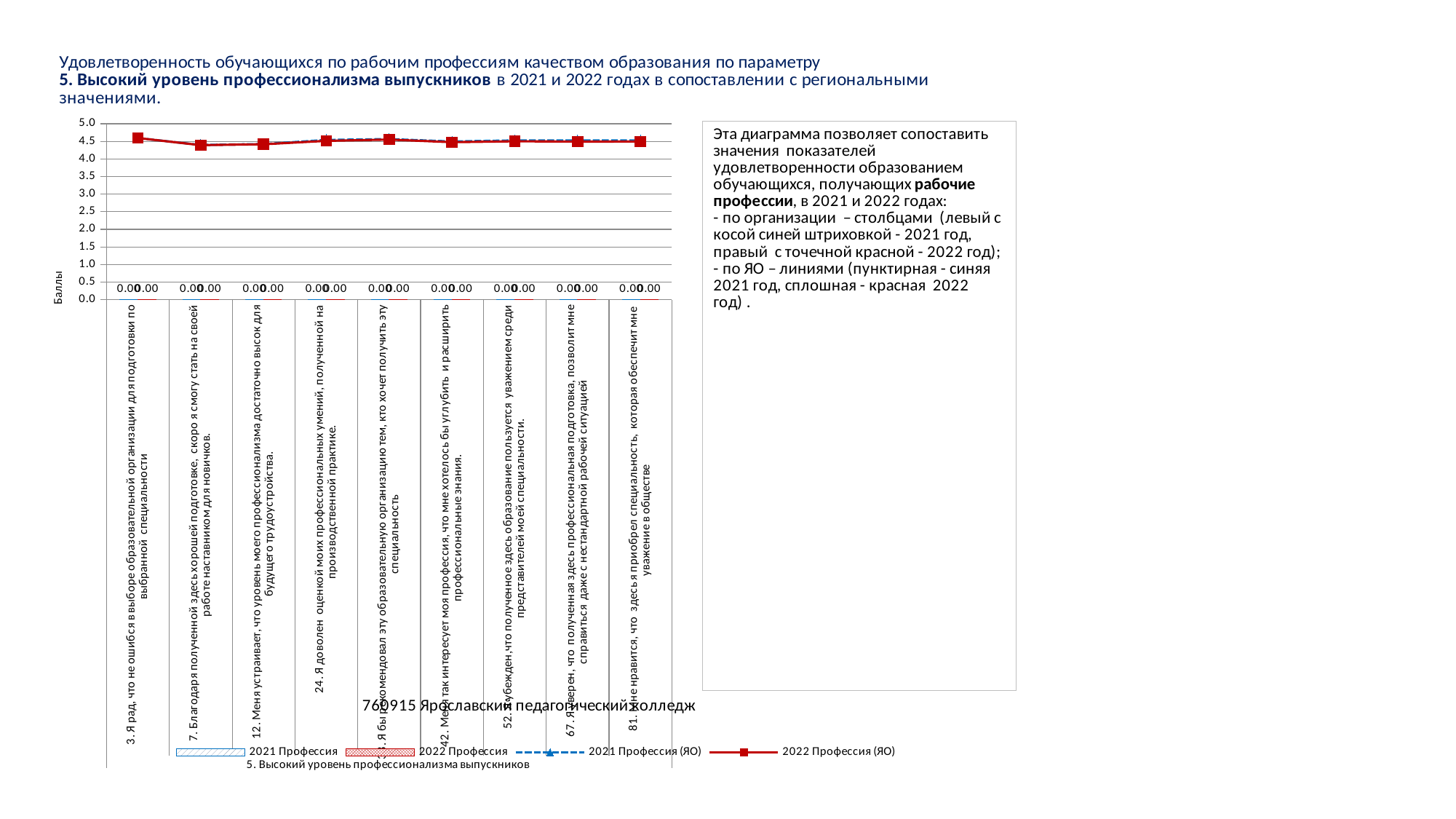
How many categories (statements) are plotted along the x axis of the chart? 9 Which series in the legend is drawn as a solid red line with square markers? 2022 Профессия (ЯО) What is the title of the vertical axis of the chart? Баллы What is the highest value shown on the vertical axis of the chart? 5.0 How many series does the chart legend list? 4 What is the printed value of the 2022 Профессия bar for the category "81. Мне нравится, что здесь я приобрел специальность, которая обеспечит мне уважение в обществе"? 0.00 What kind of chart is shown on the slide? A combined bar and line chart Is the value of the 2022 Профессия (ЯО) line for the category "7. Благодаря полученной здесь хорошей подготовке..." greater or less than 5.0? less Is the value of the 2022 Профессия (ЯО) line for the category "3. Я рад, что не ошибся в выборе образовательной организации..." greater or less than 4.0? greater Is the value of the 2021 Профессия (ЯО) line for the category "52. Я убежден, что полученное здесь образование пользуется уважением..." greater or less than 3.5? greater What is the printed value of the 2021 Профессия bar for the category "3. Я рад, что не ошибся в выборе образовательной организации для подготовки по выбранной специальности"? 0.00